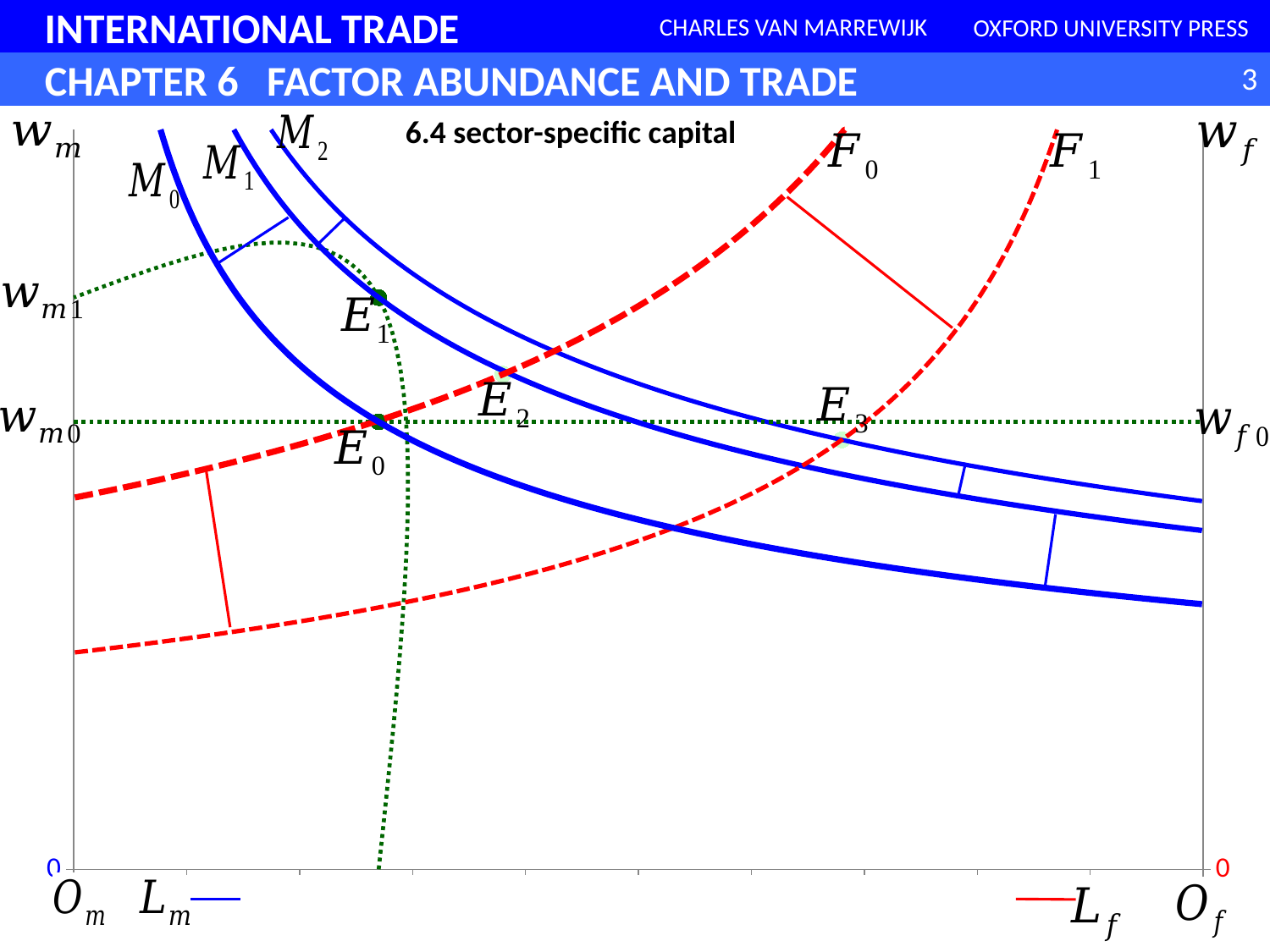
How many labelled equilibrium points (E) are marked in the chart? 4 What colour is the line for L_f in the legend at the bottom of the chart? red What is the title of the chart? 6.4 sector-specific capital How many M curves (M0, M1, M2) are drawn in the chart? 3 How many F curves are drawn in the chart? 2 Which is higher on the left vertical axis, w_m1 or w_m0? w_m1 Which labelled equilibrium point lies highest in the chart? E1 Which curve lies furthest to the right, F0 or F1? F1 What kind of chart is shown on the slide? line chart Do the red dashed F curves rise or fall as you move from left to right along the horizontal axis? rise Do the blue M curves rise or fall as you move from left to right along the horizontal axis? fall